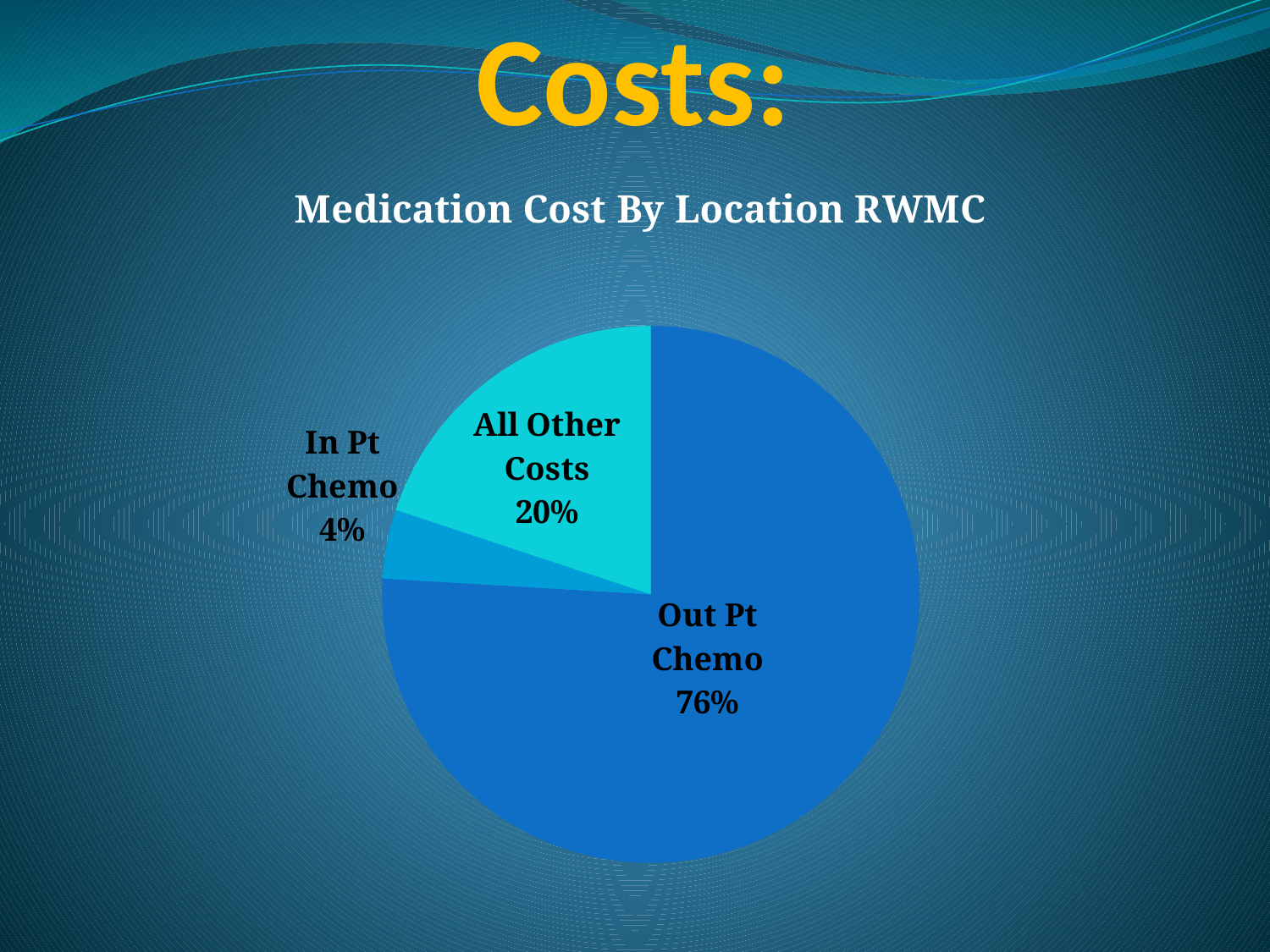
What is the difference in percentage points between Out Pt Chemo and All Other Costs? 56 What is the difference in percentage points between All Other Costs and In Pt Chemo? 16 Which category has the smallest share of the pie? In Pt Chemo What is the title of the chart? Medication Cost By Location RWMC Which is larger, the share for All Other Costs or the share for In Pt Chemo? All Other Costs What share of medication cost does In Pt Chemo account for? 4% What share of medication cost does Out Pt Chemo account for? 76% How many categories are shown in the pie chart? 3 What kind of chart is shown on the slide? Pie chart What share of medication cost does All Other Costs account for? 20% Which category has the largest share of the pie? Out Pt Chemo What is the combined share of Out Pt Chemo and In Pt Chemo? 80%